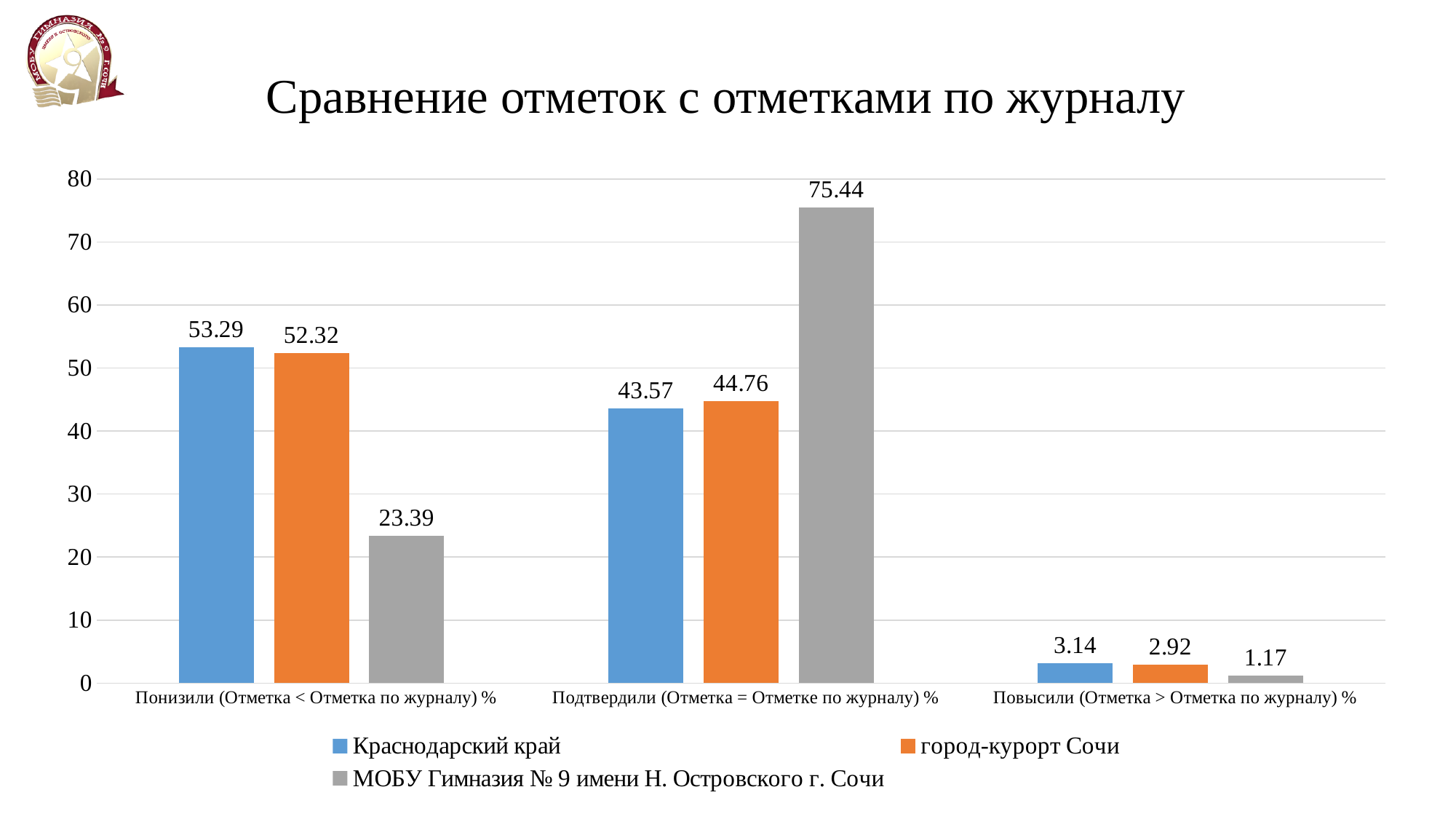
What is the value for Краснодарский край in the category Понизили (Отметка < Отметка по журналу) %? 53.29 Which is larger in the category Подтвердили (Отметка = Отметке по журналу) %: Краснодарский край or город-курорт Сочи? город-курорт Сочи How many categories are shown on the x axis? 3 What is the value for город-курорт Сочи in the category Повысили (Отметка > Отметка по журналу) %? 2.92 What is the value for МОБУ Гимназия № 9 имени Н. Островского г. Сочи in the category Подтвердили (Отметка = Отметке по журналу) %? 75.44 What is the difference between the values for Краснодарский край and МОБУ Гимназия № 9 имени Н. Островского г. Сочи in the category Понизили (Отметка < Отметка по журналу) %? 29.90 Which series has the lowest value in the category Понизили (Отметка < Отметка по журналу) %? МОБУ Гимназия № 9 имени Н. Островского г. Сочи Is the value for МОБУ Гимназия № 9 имени Н. Островского г. Сочи in the category Подтвердили (Отметка = Отметке по журналу) % greater or less than 70? greater How many series does the legend list? 3 Which series has the highest value in the category Подтвердили (Отметка = Отметке по журналу) %? МОБУ Гимназия № 9 имени Н. Островского г. Сочи What kind of chart is shown on the slide? bar chart What is the title of the chart? Сравнение отметок с отметками по журналу